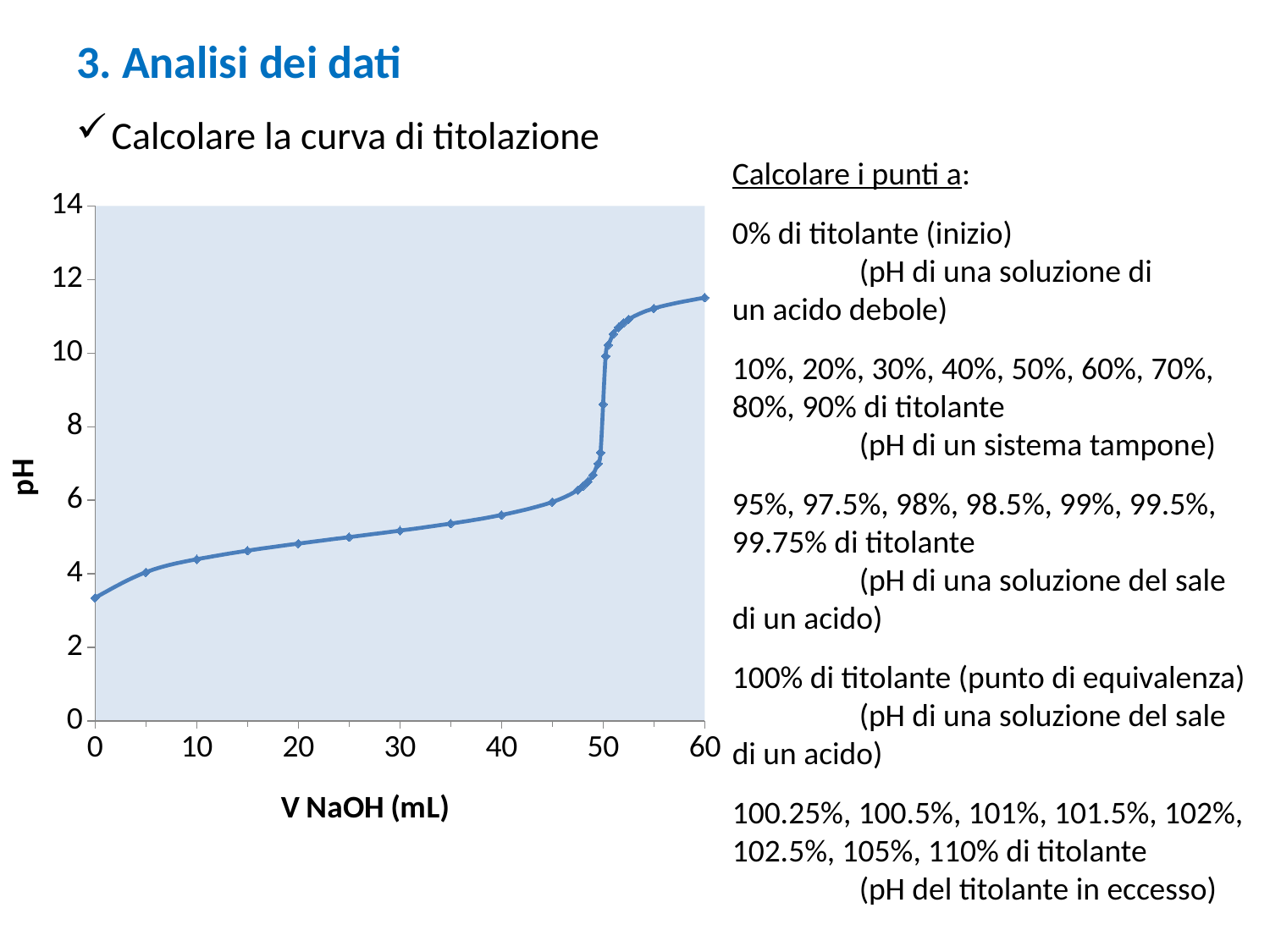
Which has the higher pH: 0 mL of NaOH or 60 mL of NaOH? 60 mL What kind of chart is shown on the slide? line chart At which volume of NaOH shown on the x axis is the pH lowest? 0 What is the label of the y axis of the chart? pH At which volume of NaOH shown on the x axis is the pH highest? 60 Is the pH at 10 mL of NaOH greater or less than 4? greater Is the pH at 60 mL of NaOH greater or less than 10? greater Is the pH at 0 mL of NaOH greater or less than 4? less Does the pH rise or fall as V NaOH increases along the x axis? rise What is the label of the x axis of the chart? V NaOH (mL)